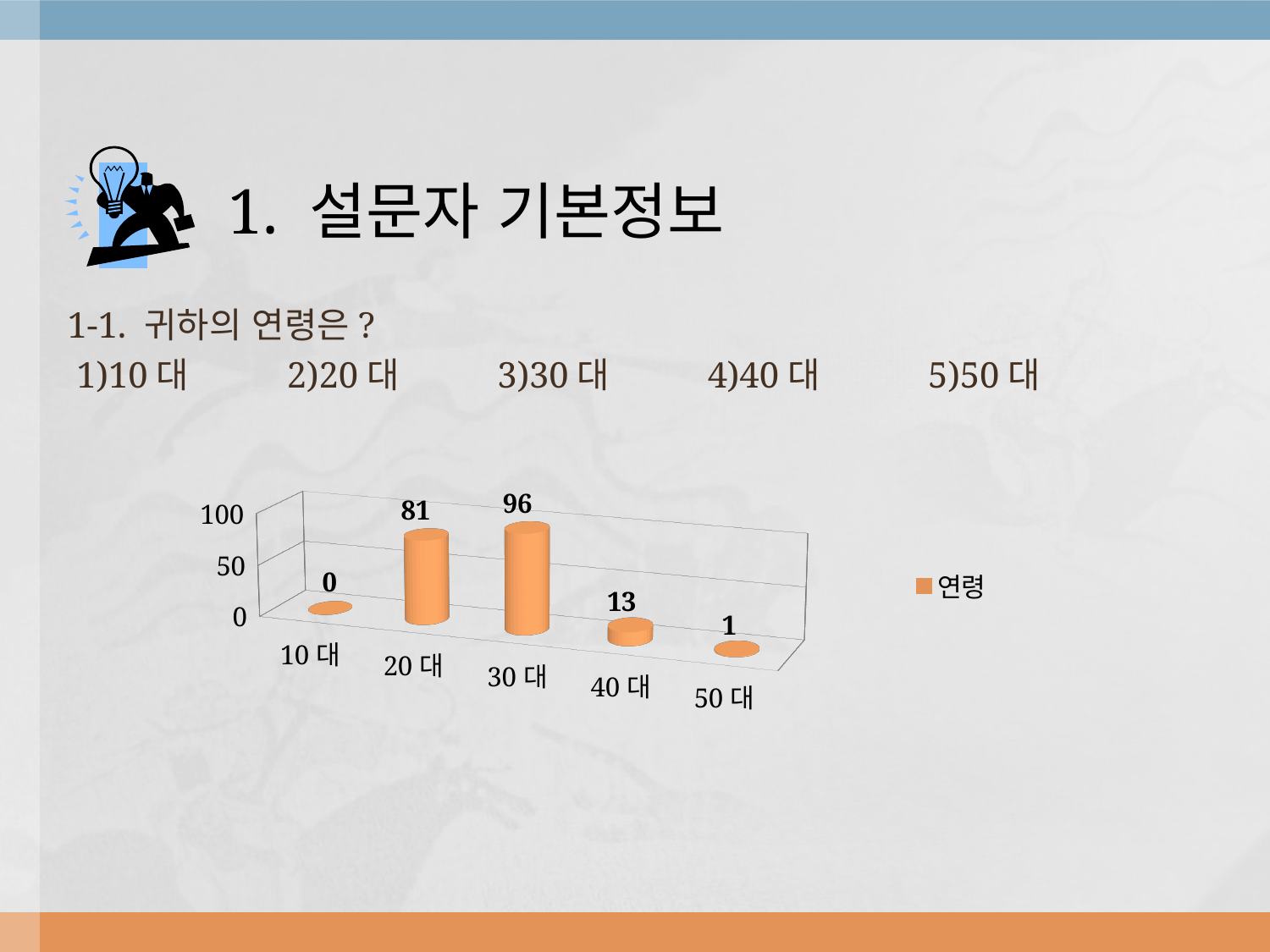
How many series does the legend list? 1 What is the difference between the values for 30 대 and 20 대? 15 What is the value for 10 대? 0 What kind of chart is shown? bar chart What is the value for 20 대? 81 What is the value for 30 대? 96 Which age group has the lowest value? 10 대 How many age categories are shown on the x axis? 5 What is the value for 40 대? 13 Is the value for 20 대 greater or less than 50? greater Which age group has the highest value? 30 대 Which is larger, the value for 40 대 or the value for 50 대? 40 대